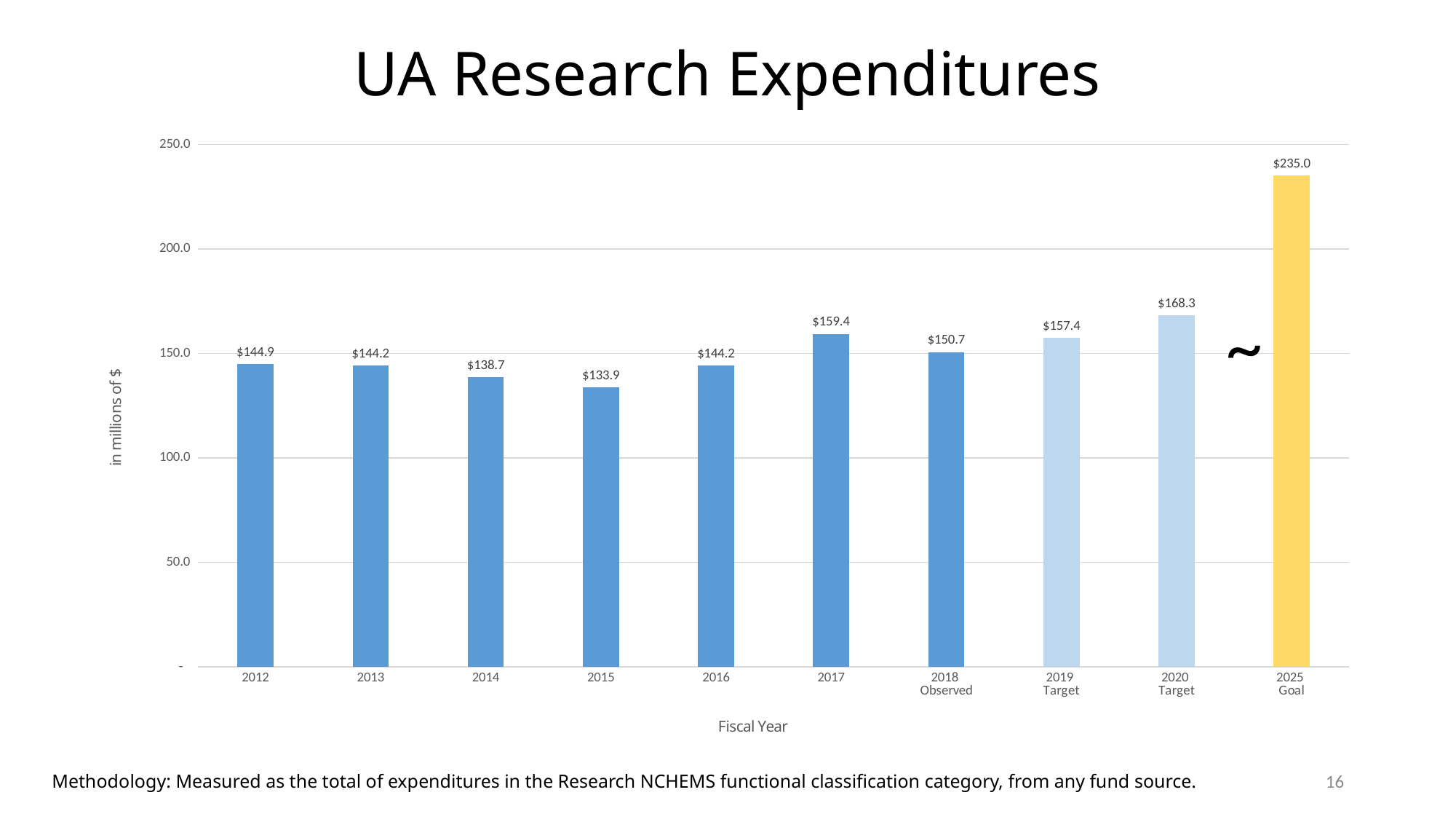
Which category has the highest value? 2025 Goal Is the value for 2014 greater or less than 150.0? less How many bars are shown in the chart? 10 What is the value for 2012? $144.9 What is the value for the 2025 Goal? $235.0 Which category has the lowest value? 2015 What is the value for 2015? $133.9 What is the title of the chart? UA Research Expenditures What kind of chart is shown on the slide? bar chart Which is larger, the value for 2017 or the value for 2018 Observed? 2017 What is the difference between the 2025 Goal and the 2020 Target? $66.7 What is the value for the 2020 Target? $168.3